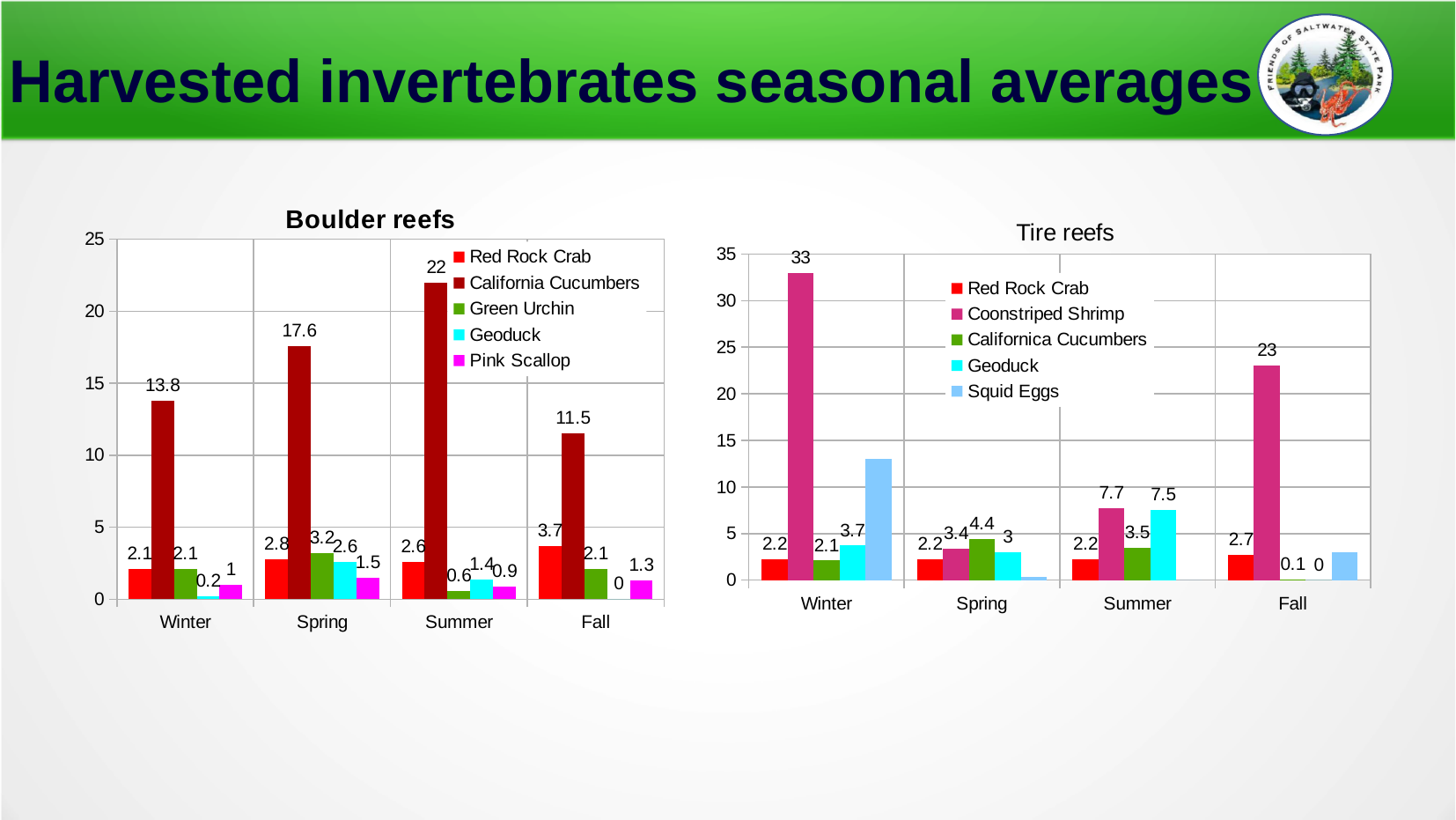
In the Boulder reefs chart, what is the value for Geoduck in Spring? 2.6 What kind of chart is the Tire reefs chart? Bar chart In the Tire reefs chart, which is larger in Summer: Coonstriped Shrimp or Geoduck? Coonstriped Shrimp In the Tire reefs chart, is the value for Squid Eggs in Winter greater or less than 10? greater In the Boulder reefs chart, how many series does the legend list? 5 In the Tire reefs chart, how many seasons are shown on the x axis? 4 In the Tire reefs chart, what is the value for Coonstriped Shrimp in Winter? 33 In the Boulder reefs chart, which season has the highest value for California Cucumbers? Summer In the Tire reefs chart, which season has the lowest value for Coonstriped Shrimp? Spring In the Tire reefs chart, what is the value for Californica Cucumbers in Spring? 4.4 In the Boulder reefs chart, what is the difference between the California Cucumbers values for Spring and Fall? 6.1 In the Boulder reefs chart, what is the value for California Cucumbers in Summer? 22